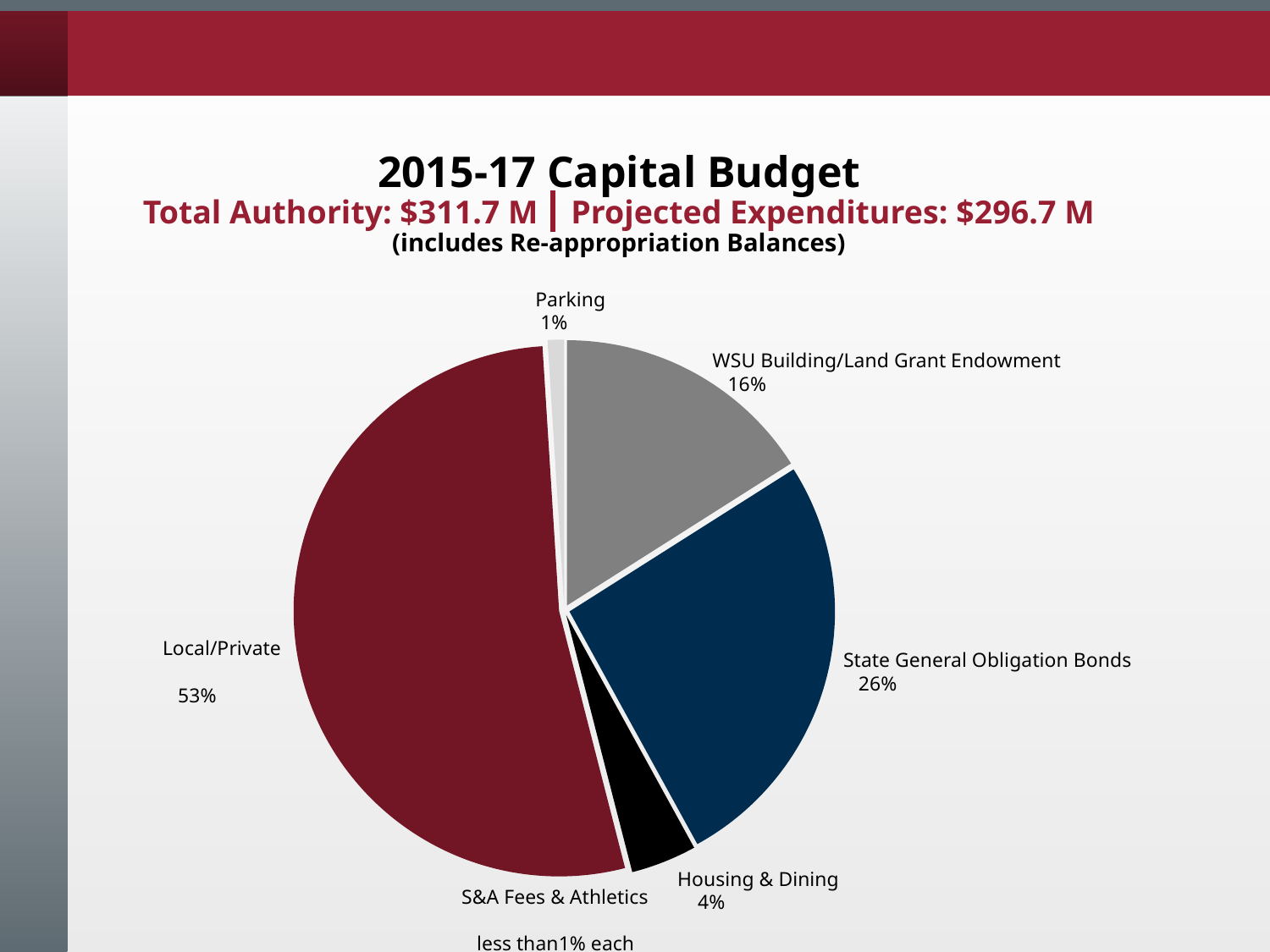
Which category has the largest slice of the pie? Local/Private What percentage is shown for State General Obligation Bonds? 26% What is the title of the chart? 2015-17 Capital Budget What share of the pie does Local/Private represent? 53% What percentage is shown for Parking? 1% What is the Total Authority amount stated in the chart subtitle? $311.7 M What percentage is shown for Housing & Dining? 4% What percentage is shown for WSU Building/Land Grant Endowment? 16% What is the difference in percentage points between Local/Private and State General Obligation Bonds? 27 What is the difference in percentage points between WSU Building/Land Grant Endowment and Housing & Dining? 12 Which is larger, State General Obligation Bonds or WSU Building/Land Grant Endowment? State General Obligation Bonds What kind of chart is shown on the slide? pie chart